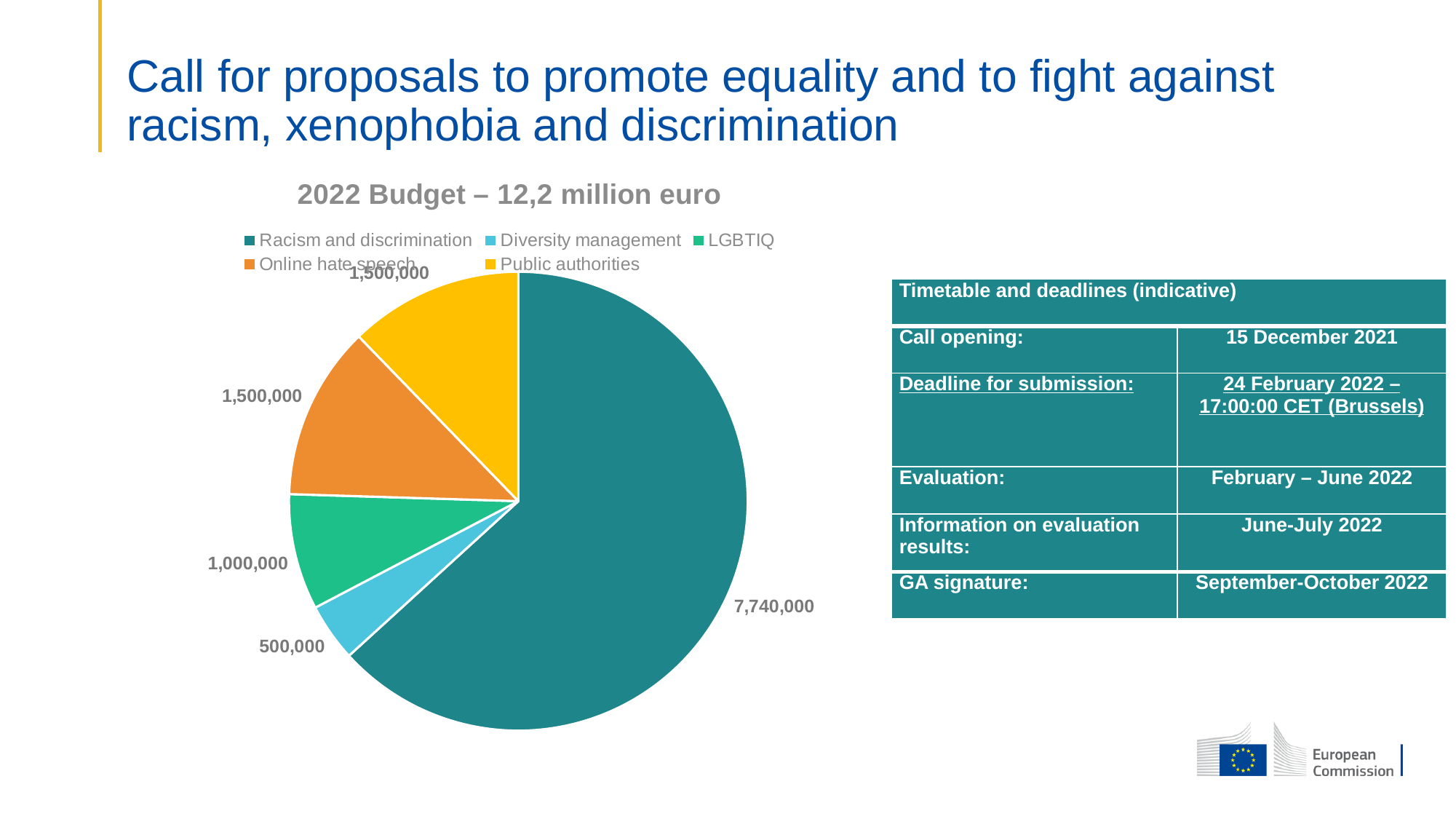
Which category has the largest slice of the pie chart? Racism and discrimination What is the title of the chart? 2022 Budget – 12,2 million euro What is the difference between the values for LGBTIQ and Diversity management? 500,000 What is the difference between the values for Racism and discrimination and Public authorities? 6,240,000 What kind of chart is shown on the slide? Pie chart What is the value for LGBTIQ in the pie chart? 1,000,000 What is the value for Racism and discrimination in the pie chart? 7,740,000 What is the value for Online hate speech in the pie chart? 1,500,000 How many categories are shown in the pie chart? 5 Which category has the smallest slice of the pie chart? Diversity management Which is larger, the value for LGBTIQ or the value for Diversity management? LGBTIQ What is the value for Diversity management in the pie chart? 500,000